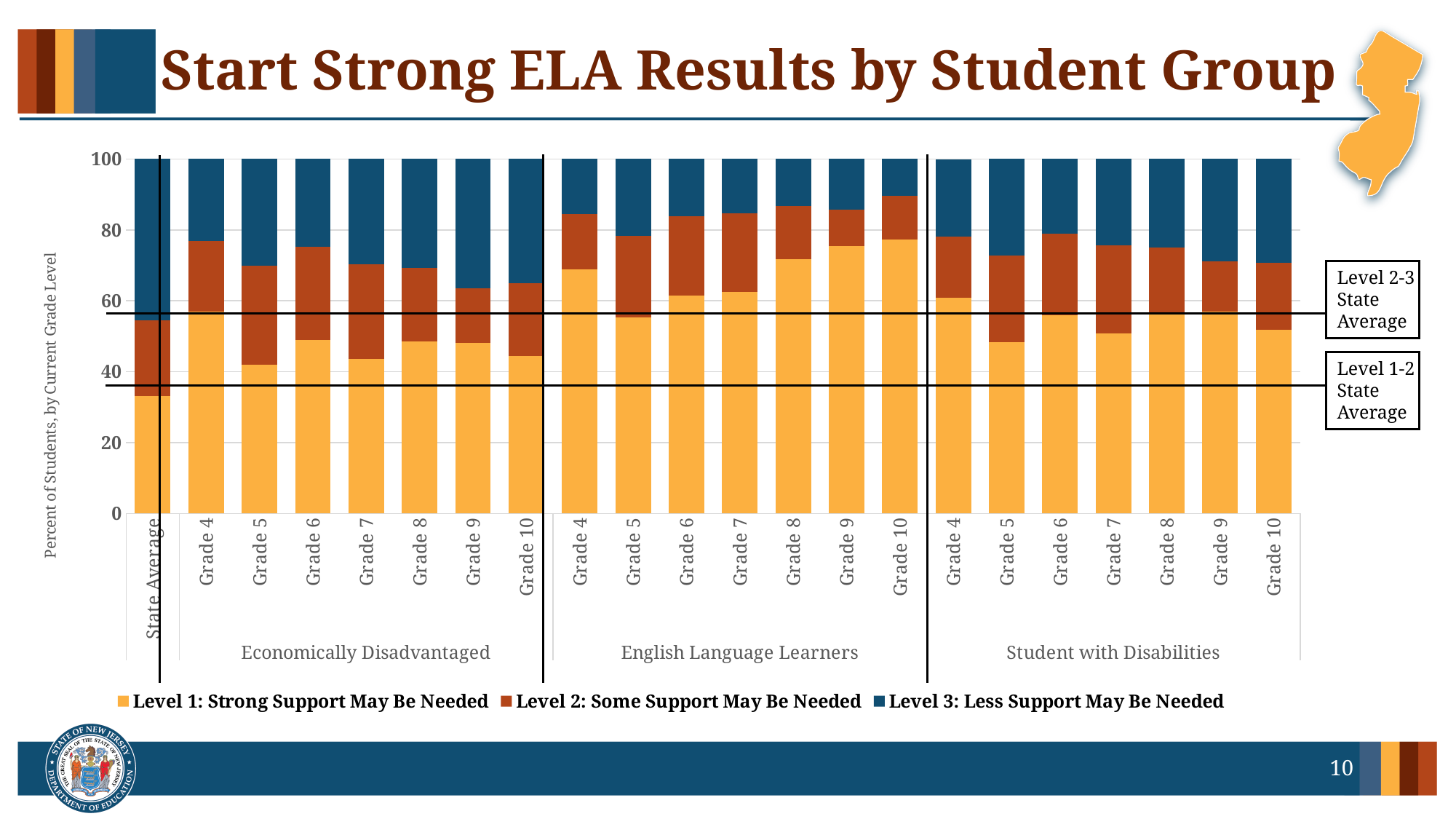
Which has a larger Level 1 value: Grade 10 in English Language Learners or Grade 5 in Economically Disadvantaged? Grade 10 in English Language Learners What kind of chart is shown on the slide? Stacked bar chart How many grade bars are shown for the English Language Learners group? 7 How many series does the legend list? 3 Is the Level 1 value for Grade 5 in the Student with Disabilities group greater or less than 60? less Is the Level 1 value for State Average greater or less than 40? less Is the Level 1 value for Grade 10 in the English Language Learners group greater or less than 60? greater Does the Level 1 value for English Language Learners rise or fall from Grade 5 to Grade 10? rise How many student groups are labelled along the x axis (excluding State Average)? 3 Which bar has the largest Level 1 segment? Grade 10, English Language Learners What is the title of the chart on the slide? Start Strong ELA Results by Student Group Which bar has the smallest Level 1 segment? State Average